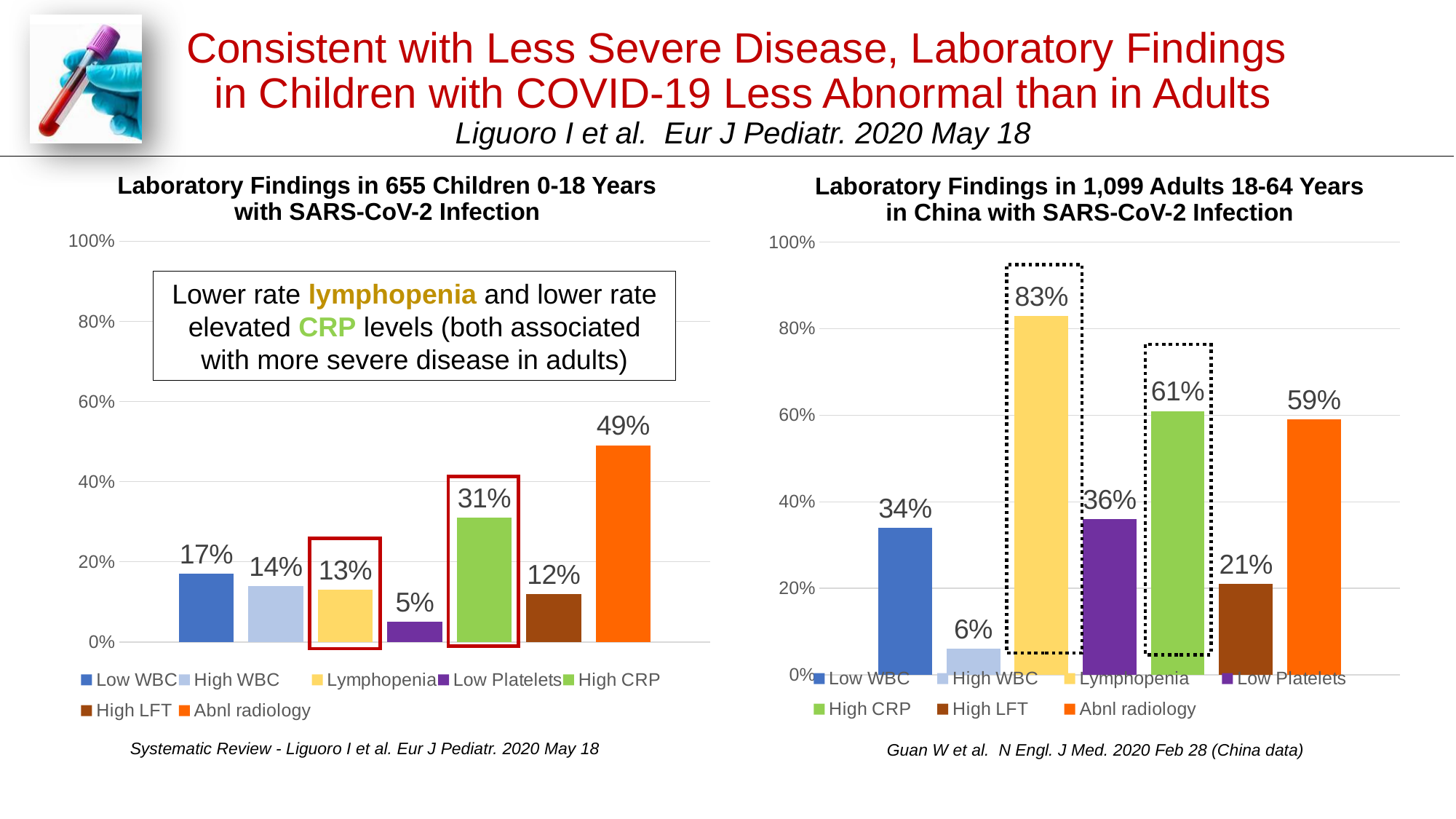
In the adults chart (right), which category has the highest value? Lymphopenia In the children chart (left), what is the value for Low Platelets? 5% How many categories are plotted in the children chart (left)? 7 In the adults chart (right), what is the value for High CRP? 61% In the children chart (left), which category has the highest value? Abnl radiology What kind of chart is the adults chart (right)? bar chart In the children chart (left), what is the value for Lymphopenia? 13% What is the difference between the Lymphopenia value in the adults chart (right) and the Lymphopenia value in the children chart (left)? 70% In the adults chart (right), is the value for Low Platelets greater or less than 20%? greater In the adults chart (right), which category has the lowest value? High WBC What is the title of the chart on the right? Laboratory Findings in 1,099 Adults 18-64 Years in China with SARS-CoV-2 Infection In the children chart (left), which is larger: Low WBC or High WBC? Low WBC